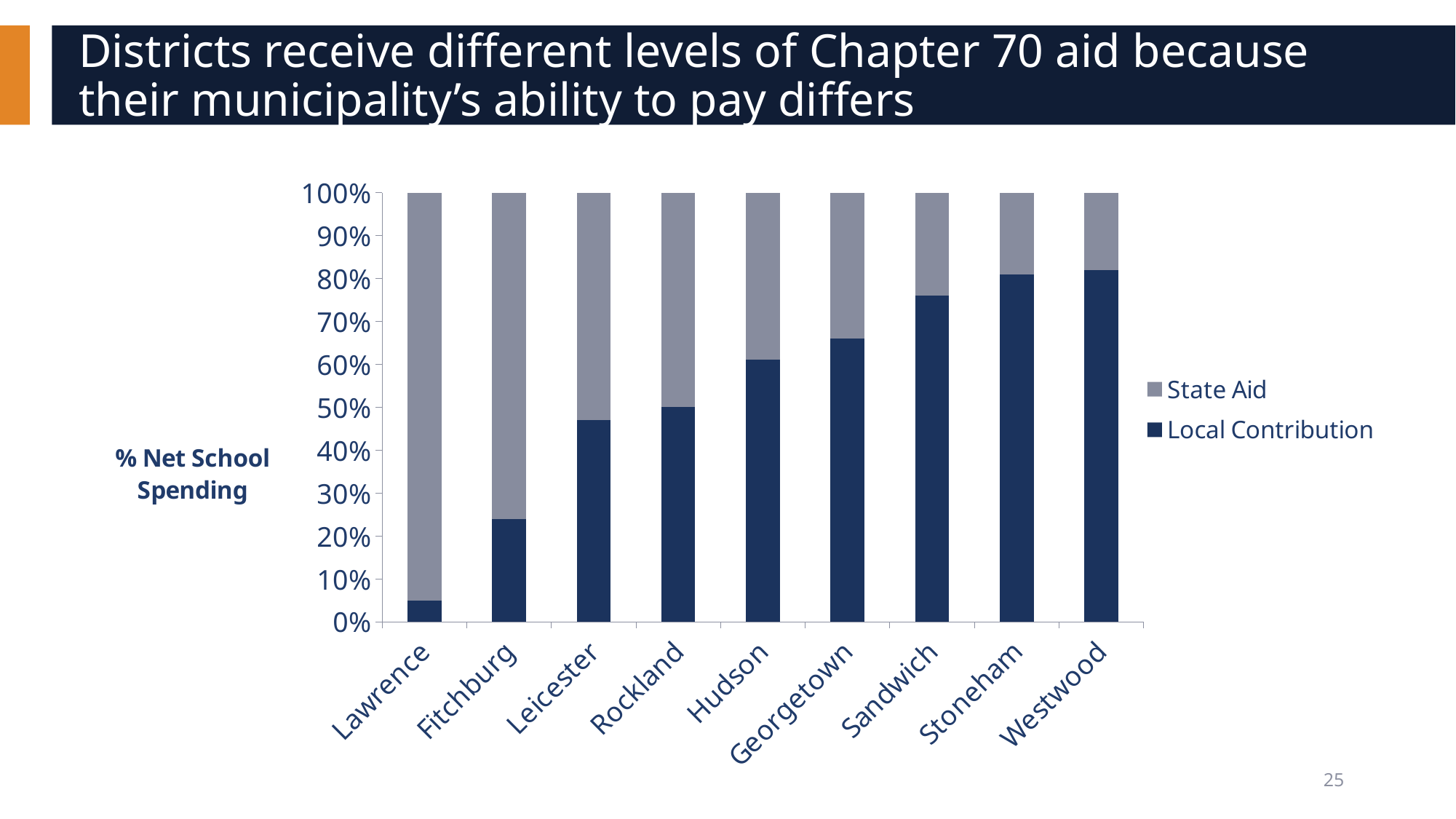
Which district has the larger Local Contribution share, Fitchburg or Leicester? Leicester Is the Local Contribution value for Lawrence greater or less than 10%? less Is the Local Contribution value for Fitchburg greater or less than 30%? less Which district has the lowest Local Contribution share? Lawrence Which district has the larger State Aid share, Hudson or Georgetown? Hudson What kind of chart is shown on the slide? Stacked bar chart Which district has the highest State Aid share? Lawrence Is the Local Contribution value for Sandwich greater or less than 70%? greater Does the Local Contribution share rise or fall moving from Lawrence to Westwood along the x axis? Rise What is the label on the vertical axis of the chart? % Net School Spending How many districts are shown on the x axis of the chart? 9 How many series does the chart's legend list? 2